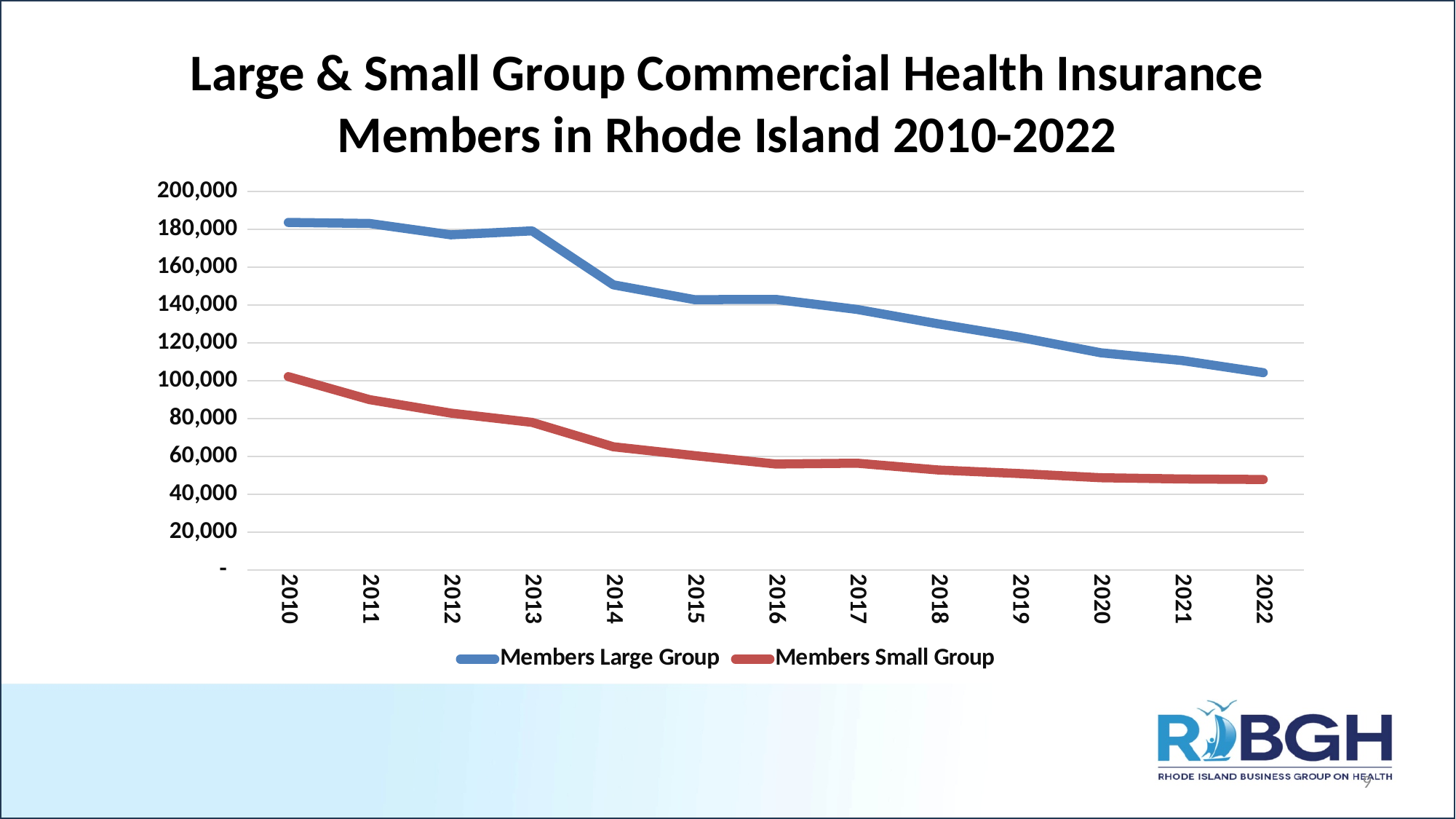
Is the value for Members Small Group in 2014 greater or less than 80,000? less What kind of chart is shown on the slide? line chart Is the value for Members Large Group in 2010 greater or less than 180,000? greater How many series does the legend list? 2 Is the value for Members Large Group in 2022 greater or less than 120,000? less What colour is the line for Members Small Group? red Do the Members Large Group values rise or fall from 2010 to 2022? fall Which series has the larger value in 2016, Members Large Group or Members Small Group? Members Large Group How many years are plotted along the x axis? 13 Do the Members Small Group values rise or fall from 2010 to 2022? fall